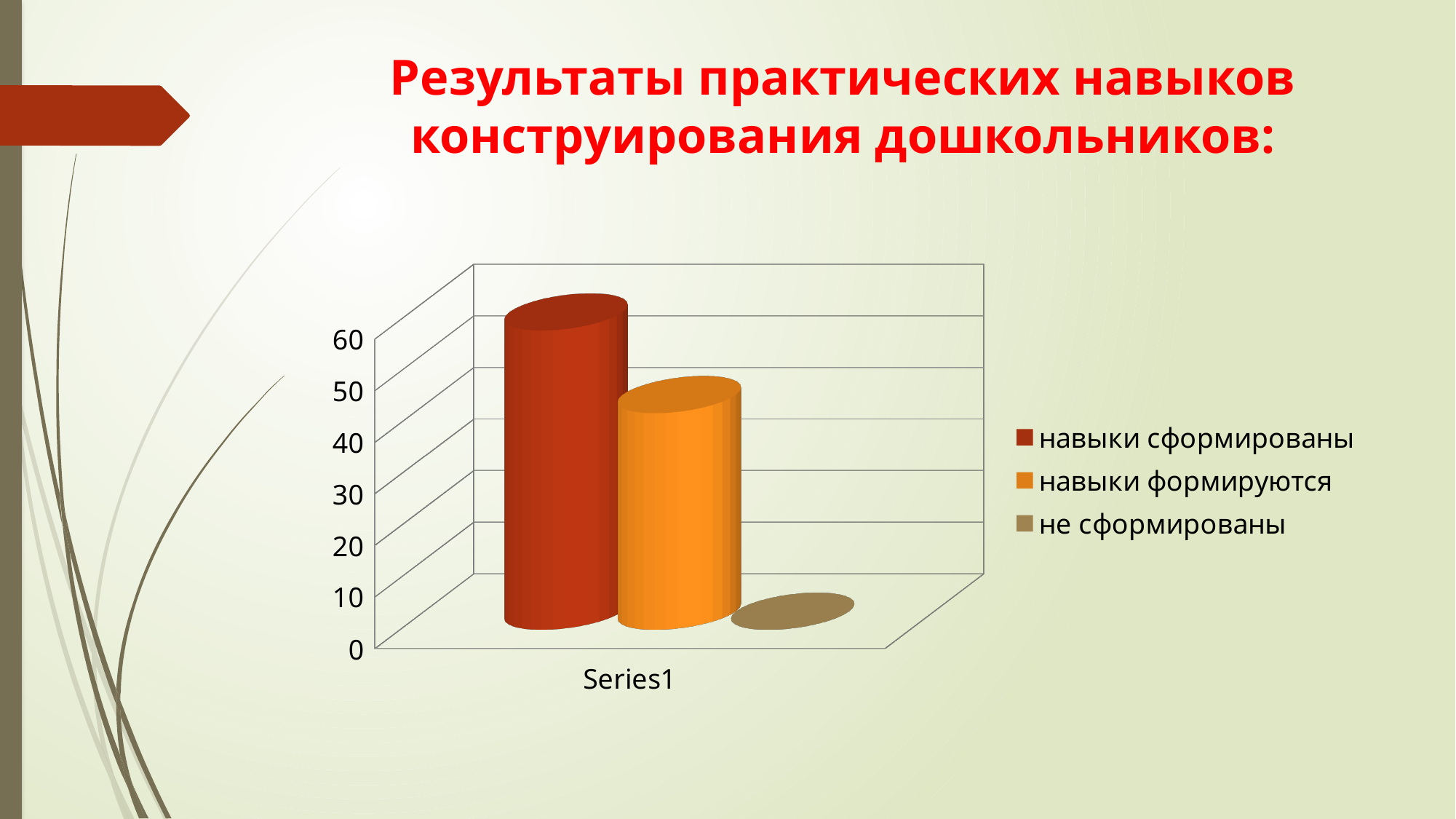
Which is larger, the value for 'навыки сформированы' or the value for 'навыки формируются'? навыки сформированы Which series has the highest value? навыки сформированы What colour represents 'навыки формируются' in the legend? orange What is the label of the category on the x axis? Series1 What kind of chart is shown on the slide? bar chart Which series has the lowest value? не сформированы Is the value for 'навыки сформированы' greater or less than 50? greater What is the value for 'не сформированы'? 0 How many series does the legend list? 3 How many categories are shown on the x axis? 1 Is the value for 'навыки формируются' greater or less than 60? less Is the value for 'навыки формируются' greater or less than 30? greater